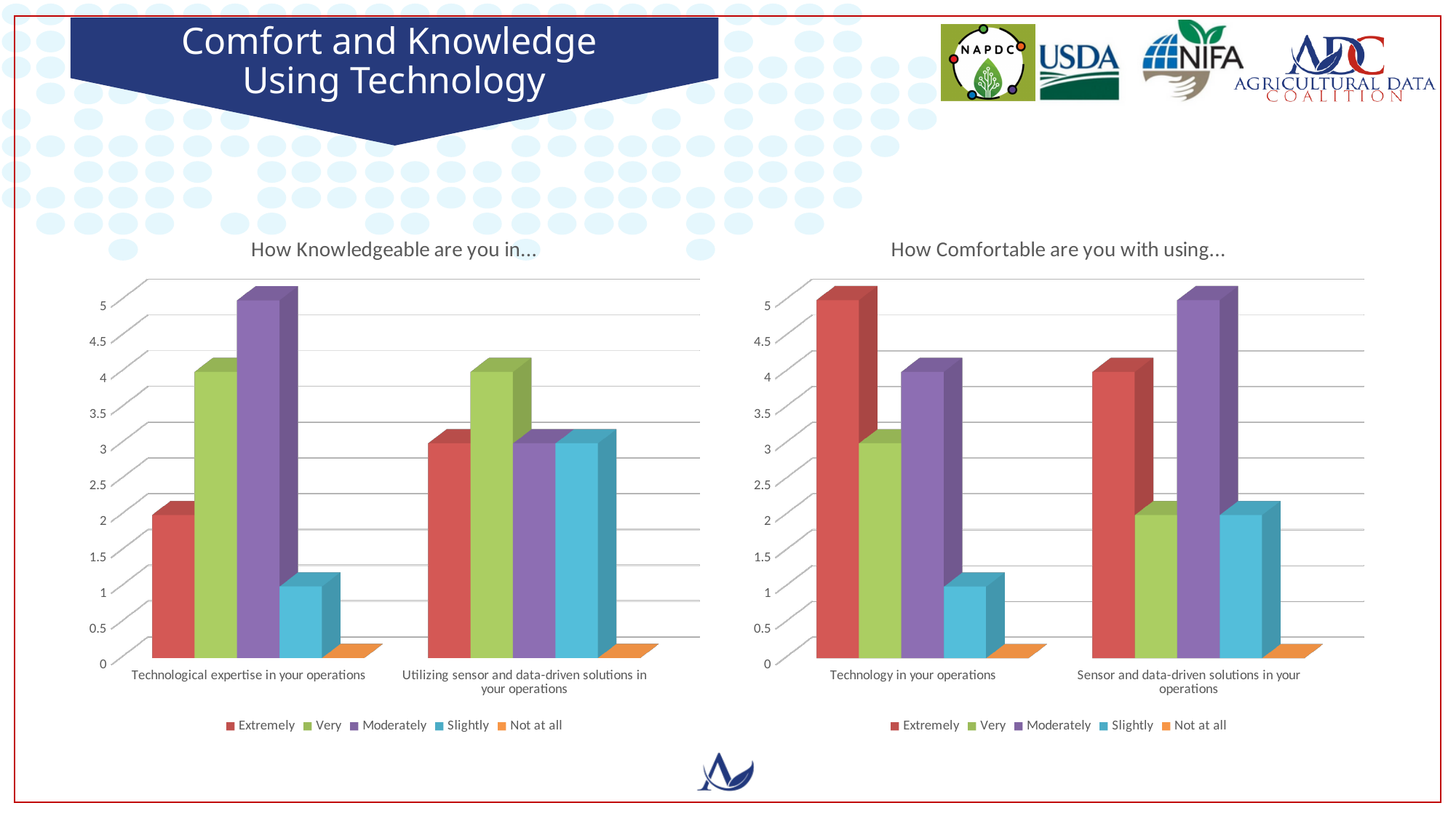
In the chart titled "How Comfortable are you with using...", what is the value for Extremely under "Technology in your operations"? 5 What kind of chart is the chart titled "How Knowledgeable are you in..."? Bar chart How many categories are shown on the x axis of the chart titled "How Comfortable are you with using..."? 2 In the chart titled "How Comfortable are you with using...", which response level is highest for "Sensor and data-driven solutions in your operations"? Moderately In the chart titled "How Knowledgeable are you in...", is the value for Slightly under "Technological expertise in your operations" greater or less than 2? less In the chart titled "How Comfortable are you with using...", which colour represents the Moderately series? Purple In the chart titled "How Comfortable are you with using...", which is larger for "Technology in your operations": Extremely or Slightly? Extremely In the chart titled "How Knowledgeable are you in...", which response level is highest for "Technological expertise in your operations"? Moderately In the chart titled "How Comfortable are you with using...", is the value for Very under "Technology in your operations" greater or less than 2? greater In the chart titled "How Knowledgeable are you in...", what is the value for Moderately under "Technological expertise in your operations"? 5 In the chart titled "How Knowledgeable are you in...", which response level is lowest for "Utilizing sensor and data-driven solutions in your operations"? Not at all How many series does the legend list in the chart titled "How Knowledgeable are you in..."? 5